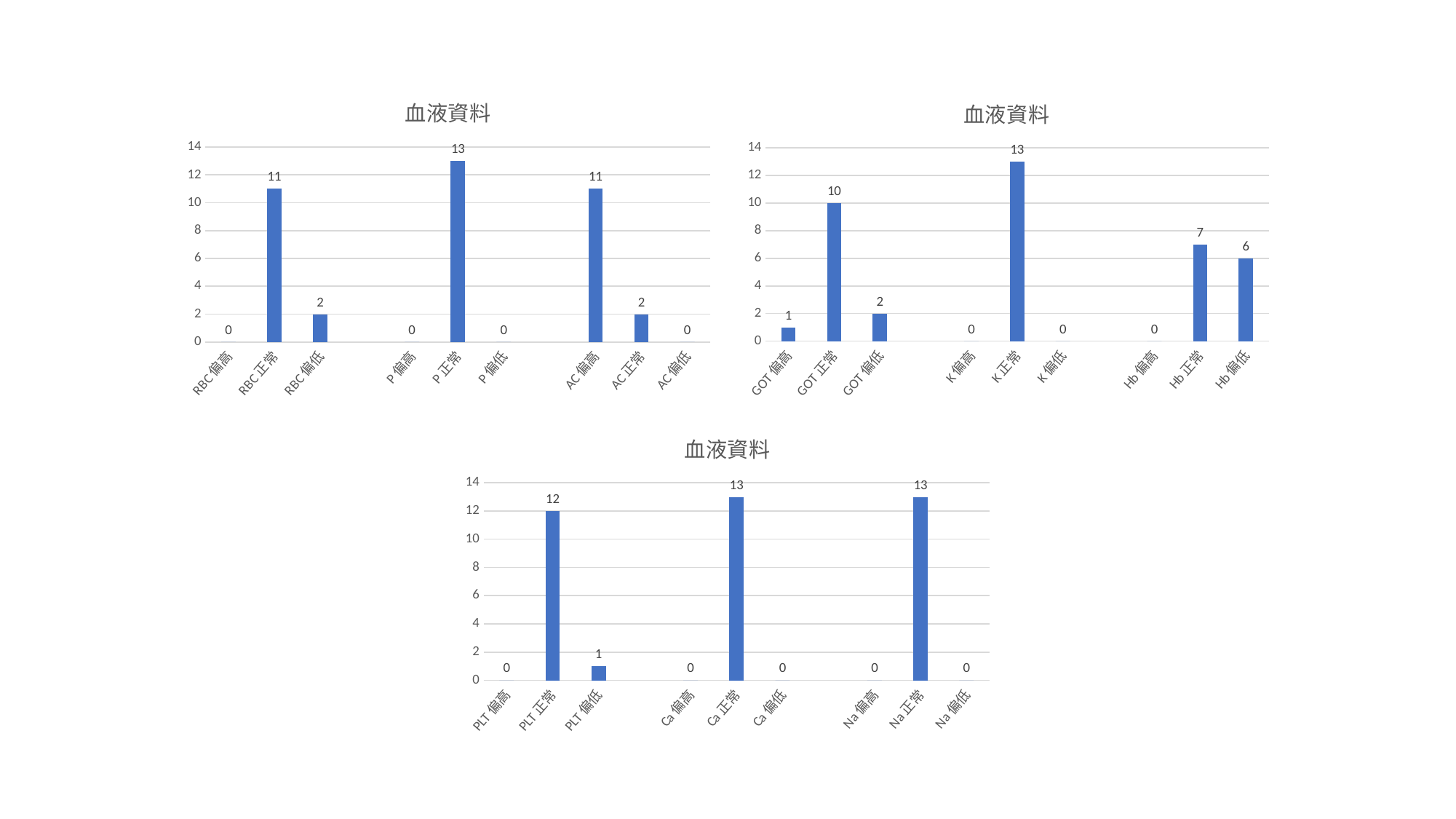
In the top-right chart, which category has the highest value? K 正常 In the bottom chart, how many categories are shown on the x axis? 9 In the top-left chart, which category has the highest value? P 正常 What kind of chart is the bottom chart? bar chart In the top-right chart, what is the value for Hb 偏低? 6 In the top-right chart, which is larger, GOT 正常 or Hb 正常? GOT 正常 In the top-left chart, what is the difference between P 正常 and AC 正常? 11 In the bottom chart, what is the value for PLT 正常? 12 In the bottom chart, what is the value for PLT 偏低? 1 In the top-right chart, what is the difference between GOT 正常 and GOT 偏低? 8 In the top-left chart, what is the value for RBC 正常? 11 What is the title of the top-right chart? 血液資料